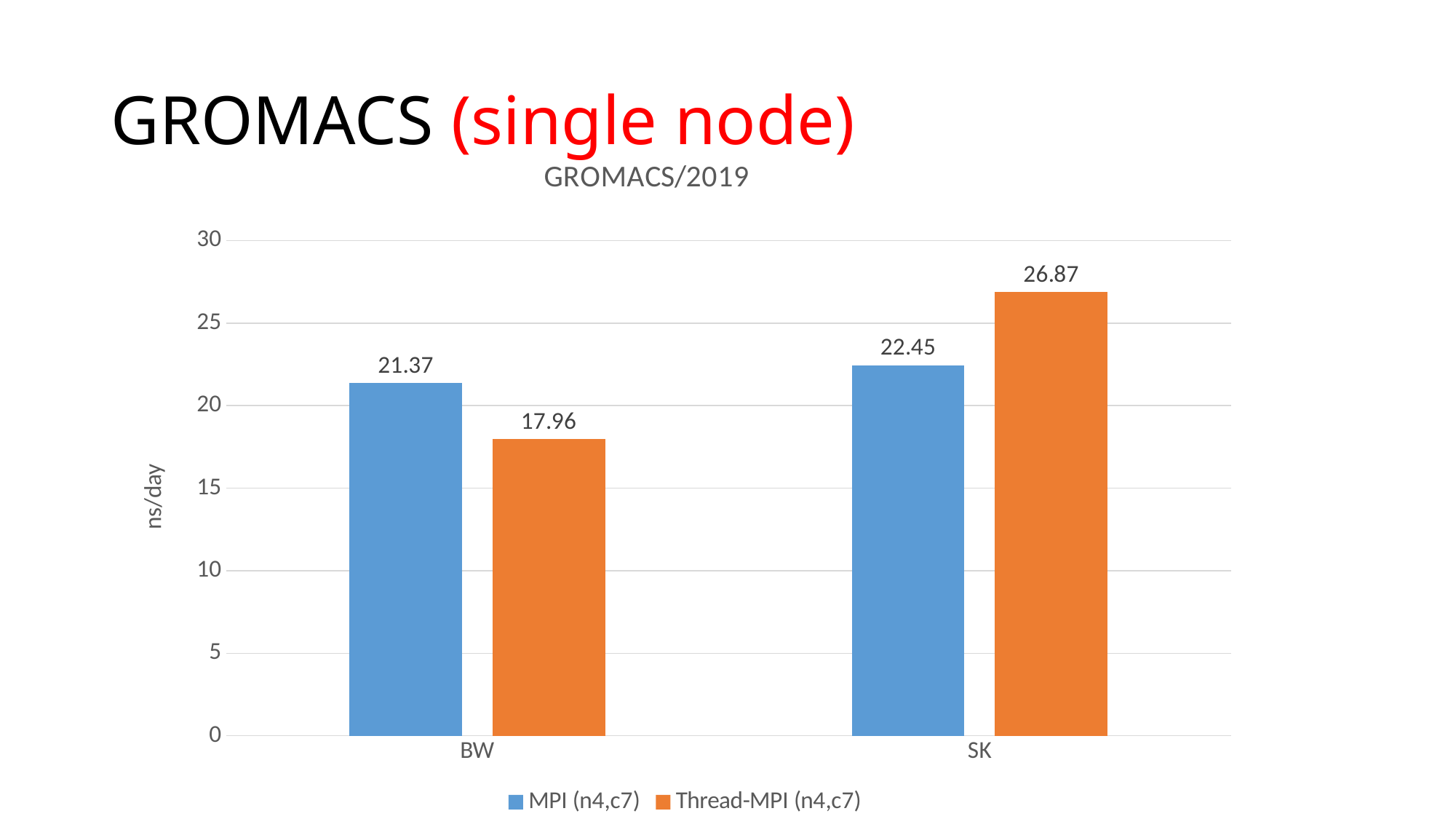
What is the title of the chart? GROMACS/2019 What is the MPI (n4,c7) value for BW? 21.37 What is the difference between the MPI (n4,c7) and Thread-MPI (n4,c7) values for BW? 3.41 For BW, which is larger: MPI (n4,c7) or Thread-MPI (n4,c7)? MPI (n4,c7) What is the Thread-MPI (n4,c7) value for SK? 26.87 Which bar has the highest value on the chart? Thread-MPI (n4,c7) for SK What kind of chart is shown on the slide? Bar chart What is the Thread-MPI (n4,c7) value for BW? 17.96 What is the MPI (n4,c7) value for SK? 22.45 What is the difference between the Thread-MPI (n4,c7) and MPI (n4,c7) values for SK? 4.42 How many series does the legend list? 2 Which bar has the lowest value on the chart? Thread-MPI (n4,c7) for BW